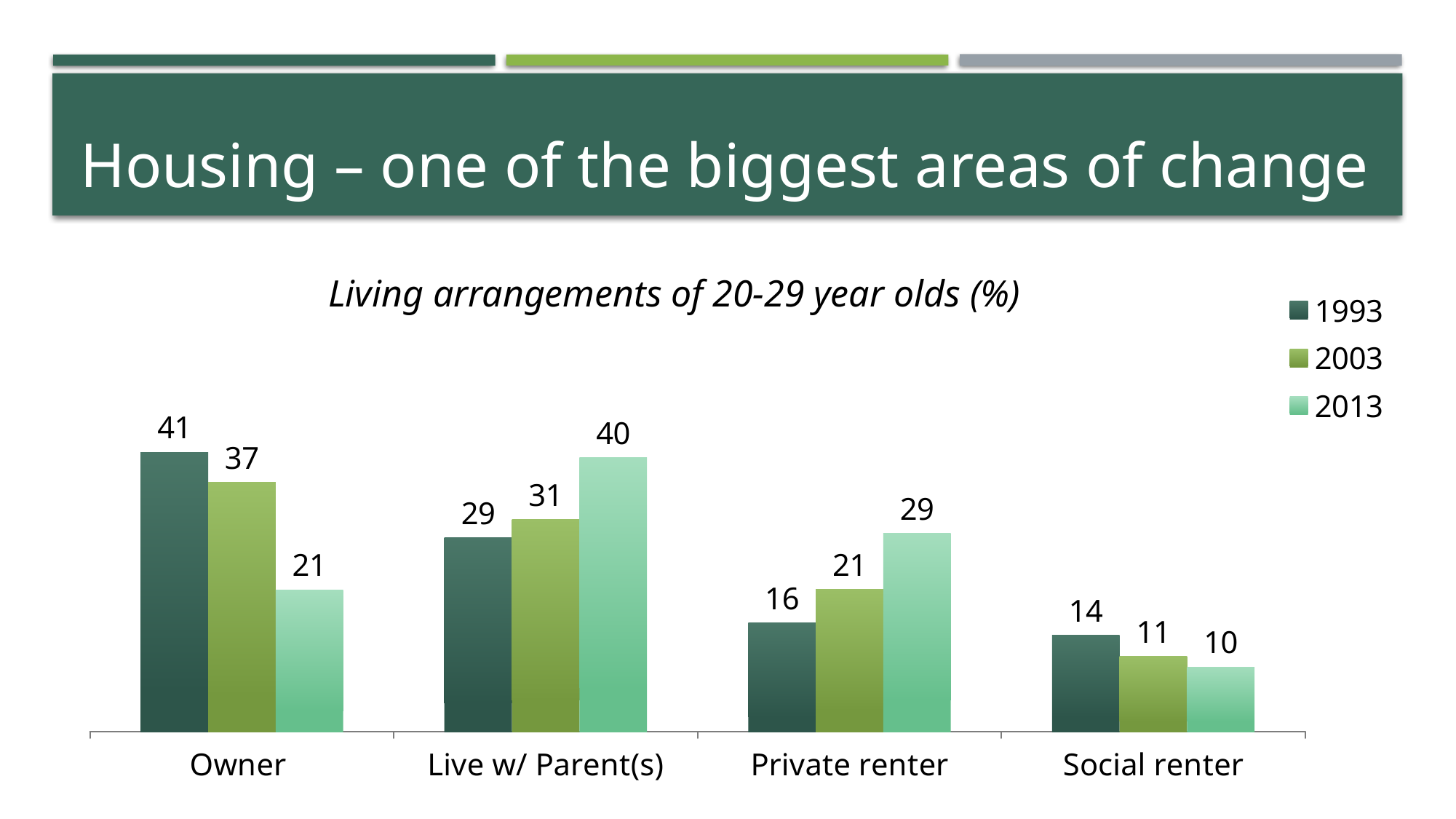
Which category has the highest value in the 2013 series? Live w/ Parent(s) How many categories are shown on the x axis? 4 Which is larger: the 2013 value for Private renter or the 2013 value for Owner? Private renter What is the title of the chart? Living arrangements of 20-29 year olds (%) How many series does the legend list? 3 Which category has the lowest value in the 1993 series? Social renter What is the value for Social renter in 2013? 10 What is the difference between the 1993 and 2013 values for Owner? 20 What is the value for Owner in 1993? 41 What is the value for Private renter in 2003? 21 What kind of chart is shown on the slide? Bar chart What is the value for Live w/ Parent(s) in 2013? 40